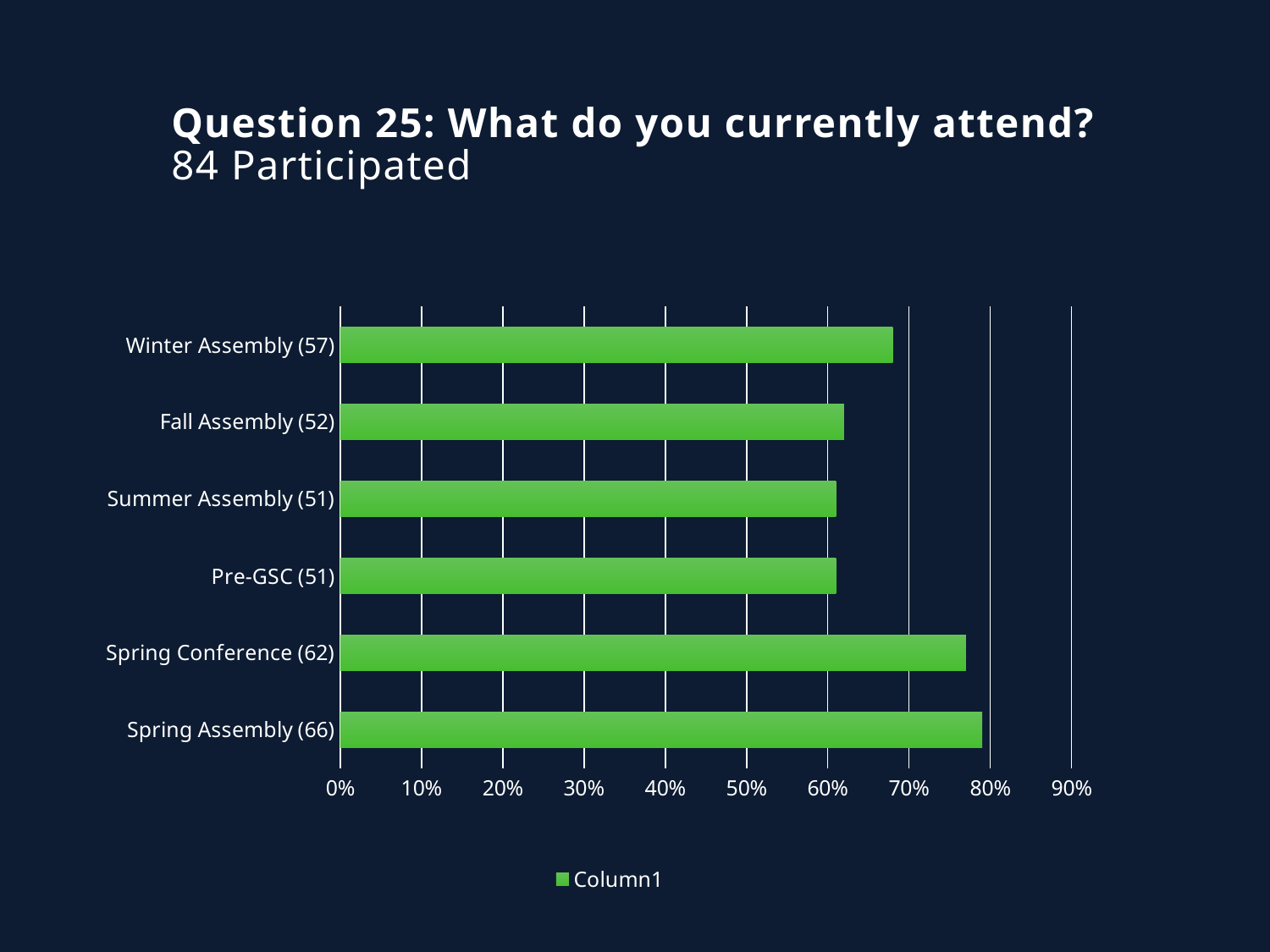
How many series does the legend list? 1 Which category has the highest value in the chart? Spring Assembly (66) What kind of chart is shown on the slide? bar chart How many categories are plotted in the chart? 6 Is the value for Winter Assembly greater or less than 60%? greater Which is larger, the value for Spring Conference or the value for Summer Assembly? Spring Conference What is the legend entry shown below the chart? Column1 Is the value for Spring Conference greater or less than 70%? greater Which is larger, the value for Winter Assembly or the value for Fall Assembly? Winter Assembly According to the category label, how many respondents attend the Winter Assembly? 57 Is the value for Pre-GSC greater or less than 50%? greater